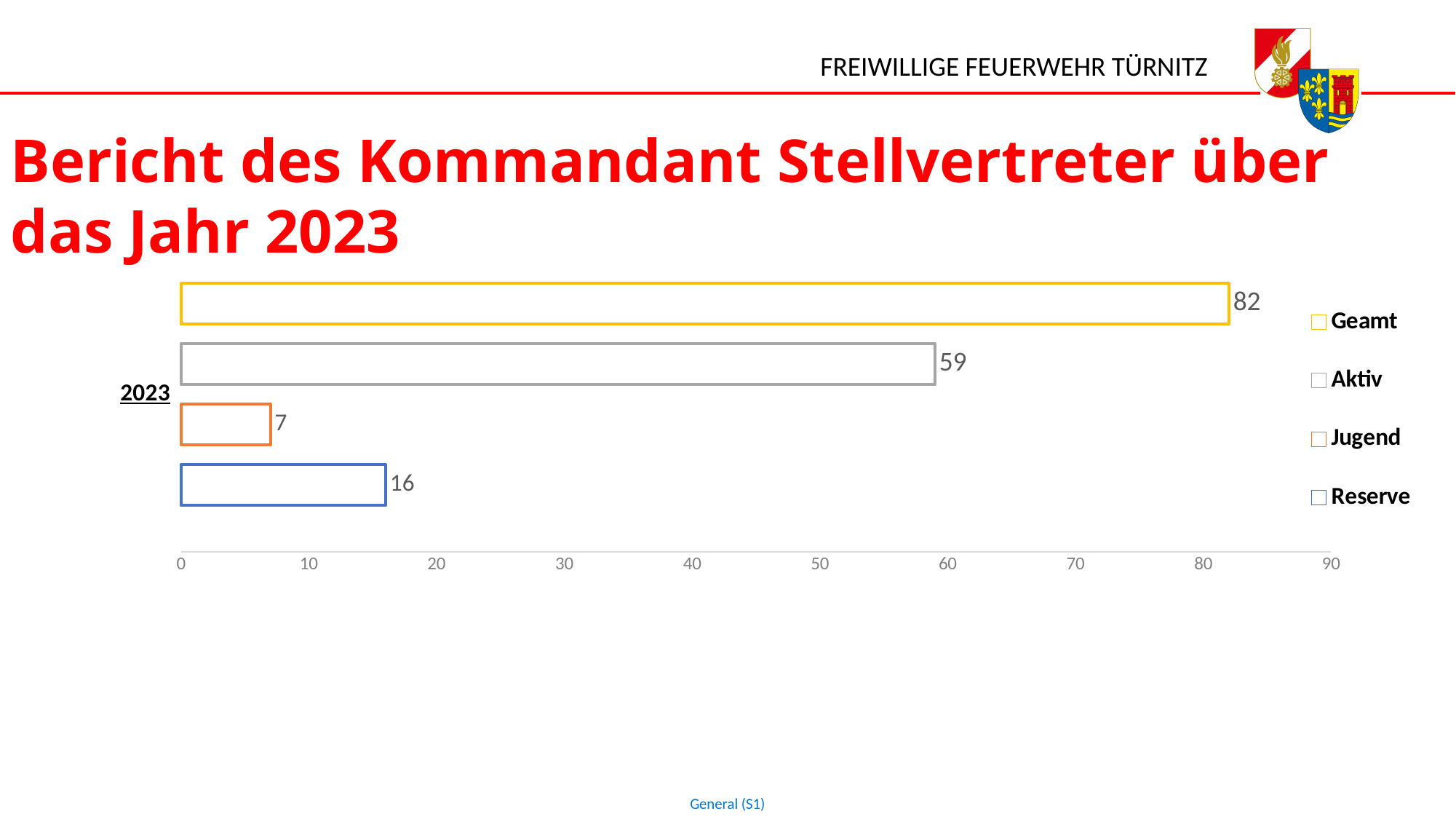
Which series has the lowest value for 2023? Jugend How many series does the legend list? 4 What is the value of the Reserve series for 2023? 16 What is the difference between the Reserve and Jugend values for 2023? 9 What is the value of the Jugend series for 2023? 7 Which is larger for 2023, Reserve or Jugend? Reserve What is the only category shown on the vertical axis of the chart? 2023 What is the value of the Aktiv series for 2023? 59 What is the difference between the Geamt and Aktiv values for 2023? 23 What is the value of the Geamt series for 2023? 82 What kind of chart is shown on the slide? Bar chart Which series has the highest value for 2023? Geamt